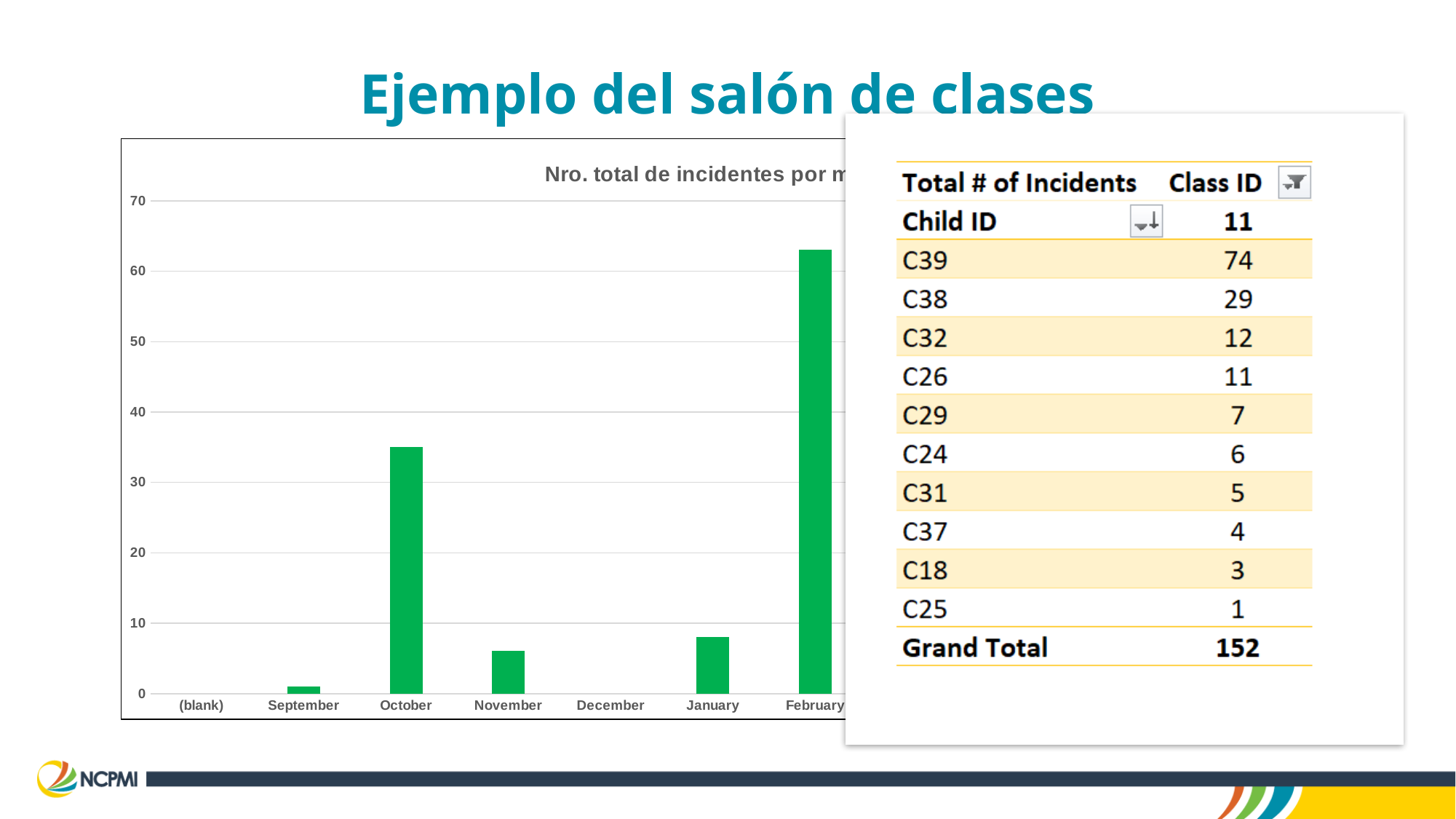
Is the value for September greater or less than 10? less Is the value for October greater or less than 30? greater Is the value for January greater or less than 10? less Which has a larger value, October or November? October What kind of chart is shown on the slide? bar chart Among the months visible on the chart, which has the highest number of incidents? February What colour are the bars in the chart? green Which has a larger value, January or February? February What is the highest value shown on the chart's vertical axis? 70